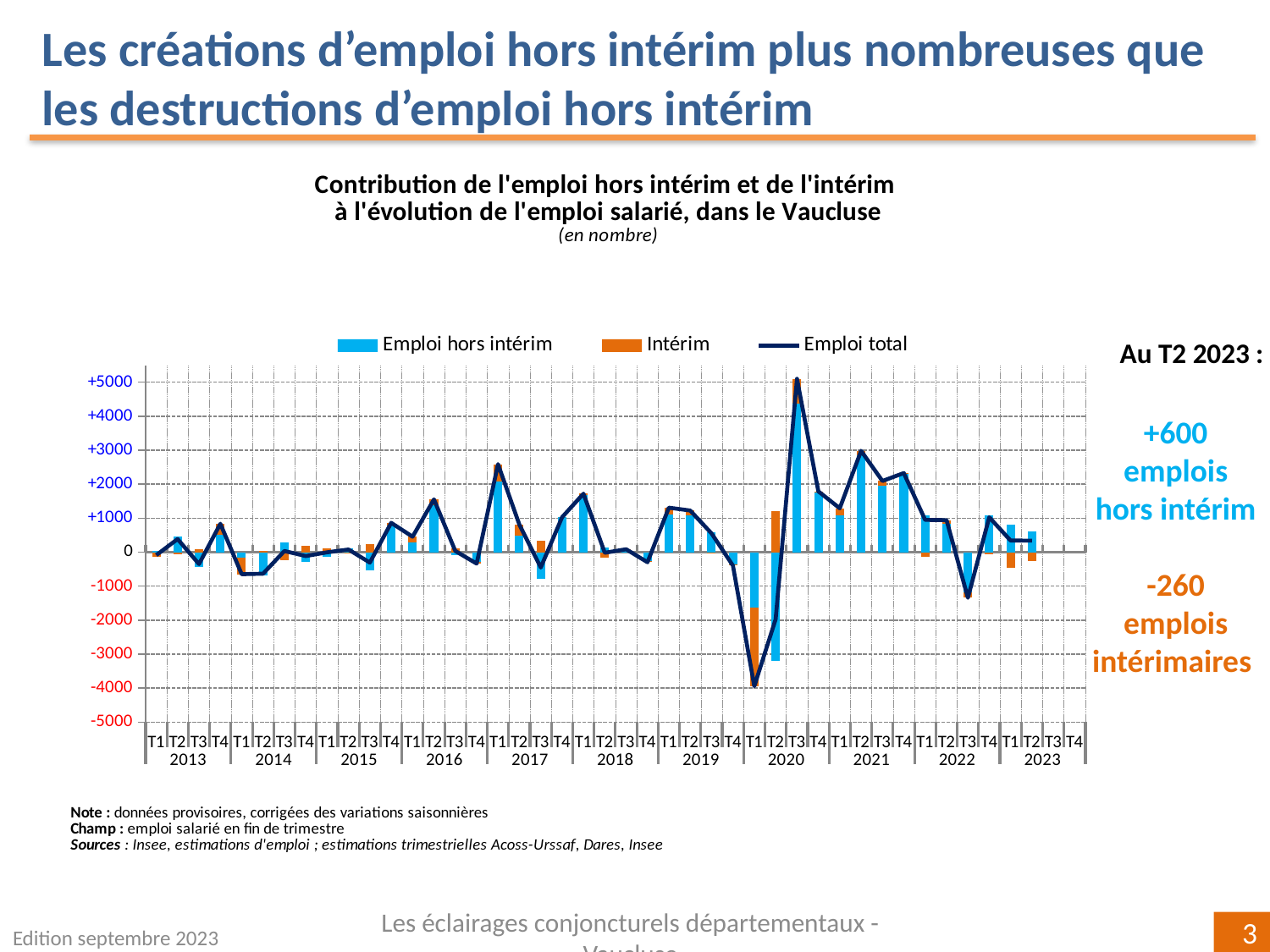
In which quarter does the Emploi total line reach its lowest value? T1 2020 Combining the two contributions shown for T2 2023 (+600 and -260), what is the total change in employment? +340 Which colour represents the Intérim series in the chart? Orange Is the value of Emploi total at T3 2020 greater or less than +4000? greater According to the slide, what is the value for Emploi hors intérim at T2 2023? +600 According to the slide, what is the value for Intérim at T2 2023? -260 Between T1 2020 and T3 2020, does the Emploi total line rise or fall? rise In which quarter does the Emploi total line reach its highest value? T3 2020 Which is larger, the Emploi hors intérim bar at T3 2020 or at T2 2021? T3 2020 What kind of chart is shown on the slide? Combined bar and line chart Is the value of Emploi total at T1 2020 greater or less than -3000? less How many series does the chart legend list? 3